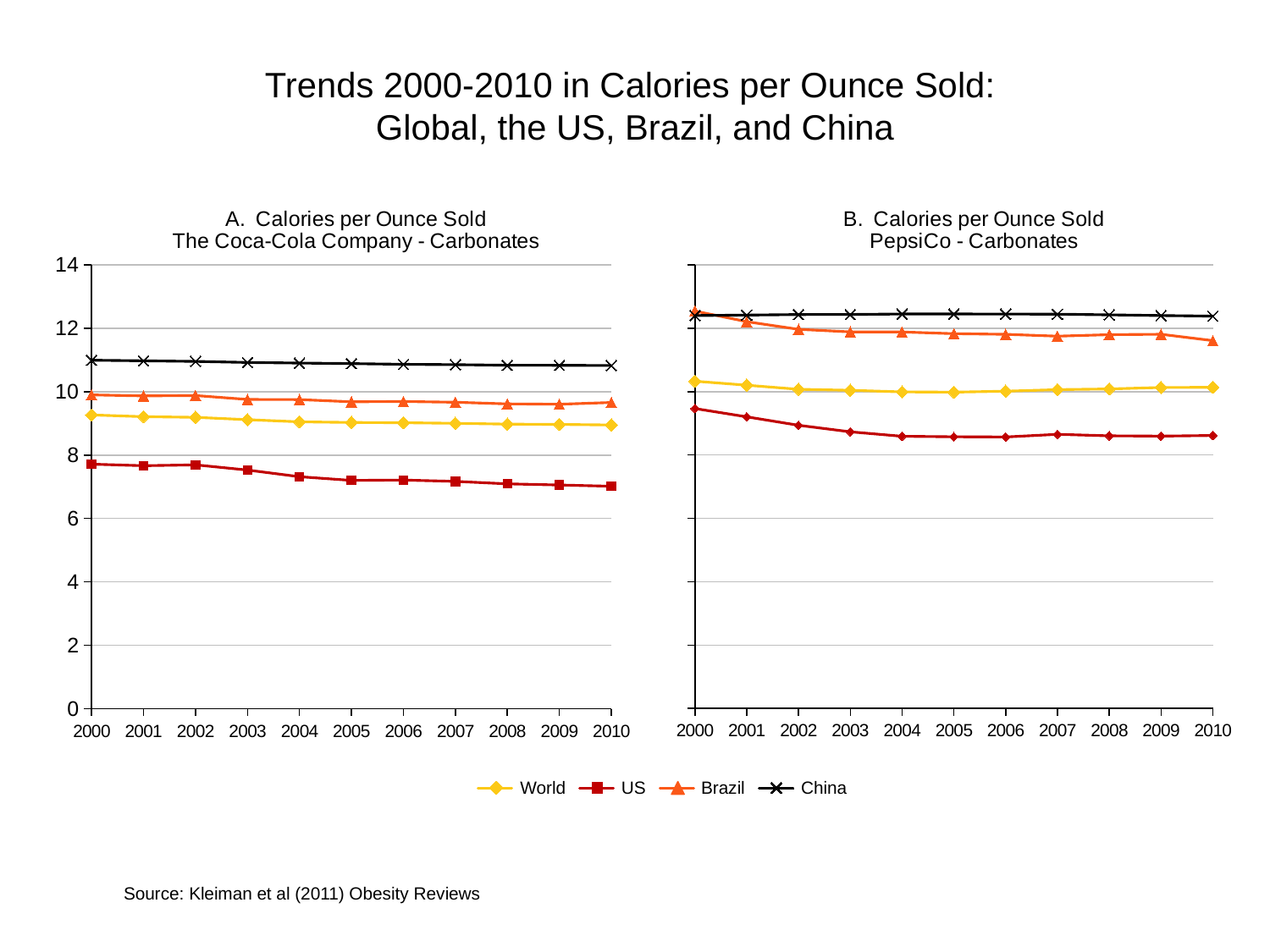
In chart A (The Coca-Cola Company - Carbonates), is the value for China in 2005 greater or less than 10? greater In chart A (The Coca-Cola Company - Carbonates), is the value for US in 2010 greater or less than 8? less In chart A (The Coca-Cola Company - Carbonates), which series has the lowest value in 2010? US In chart B (PepsiCo - Carbonates), which is larger in 2010, Brazil or World? Brazil In chart B (PepsiCo - Carbonates), is the value for US in 2010 greater or less than 10? less How many series does the legend list? 4 In chart B (PepsiCo - Carbonates), which series has the lowest value in 2010? US Which series is shown with an X marker in the legend? China How many years are plotted along the x axis of chart B (PepsiCo - Carbonates)? 11 In chart A (The Coca-Cola Company - Carbonates), which series has the highest value in 2010? China What kind of chart is chart A (The Coca-Cola Company - Carbonates)? line chart In chart A (The Coca-Cola Company - Carbonates), does the US series rise or fall from 2000 to 2010? fall